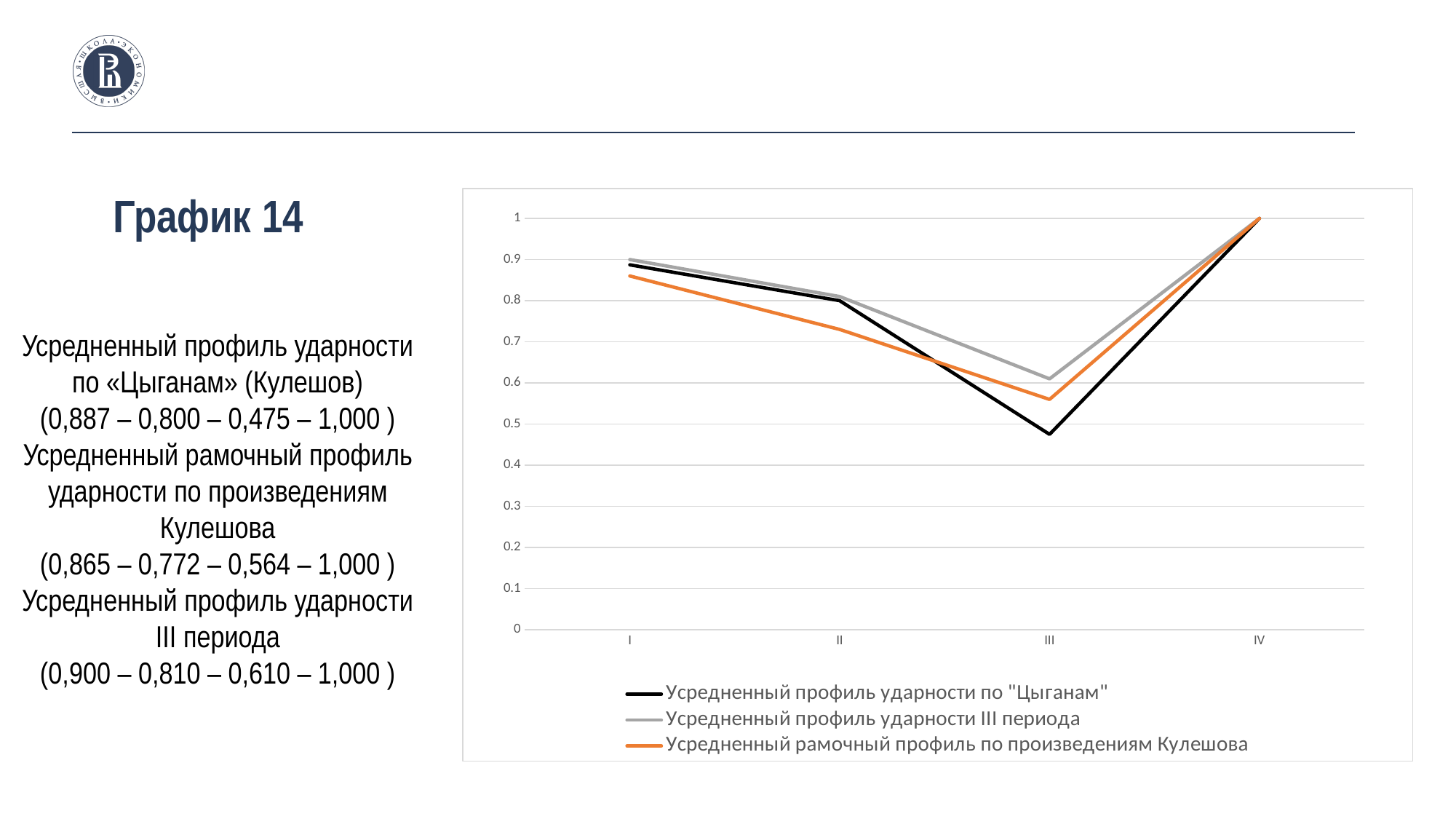
What is the difference between the values of "Усредненный профиль ударности III периода" and "Усредненный профиль ударности по «Цыганам»" at point III? 0,135 How many points are on the x axis of the chart? 4 At which x-axis point do all three series reach their highest value? IV At point III, which series has the larger value: "Усредненный рамочный профиль по произведениям Кулешова" or "Усредненный профиль ударности по «Цыганам»"? Усредненный рамочный профиль по произведениям Кулешова What is the value of the series "Усредненный профиль ударности по «Цыганам»" at point III? 0,475 What kind of chart is shown on the slide? line chart Which colour is used for the series "Усредненный рамочный профиль по произведениям Кулешова"? orange At which x-axis point does the series "Усредненный профиль ударности по «Цыганам»" reach its lowest value? III How many series does the legend list? 3 Is the value of "Усредненный профиль ударности по «Цыганам»" at point III greater or less than 0.5? less What is the value of the series "Усредненный профиль ударности III периода" at point I? 0,900